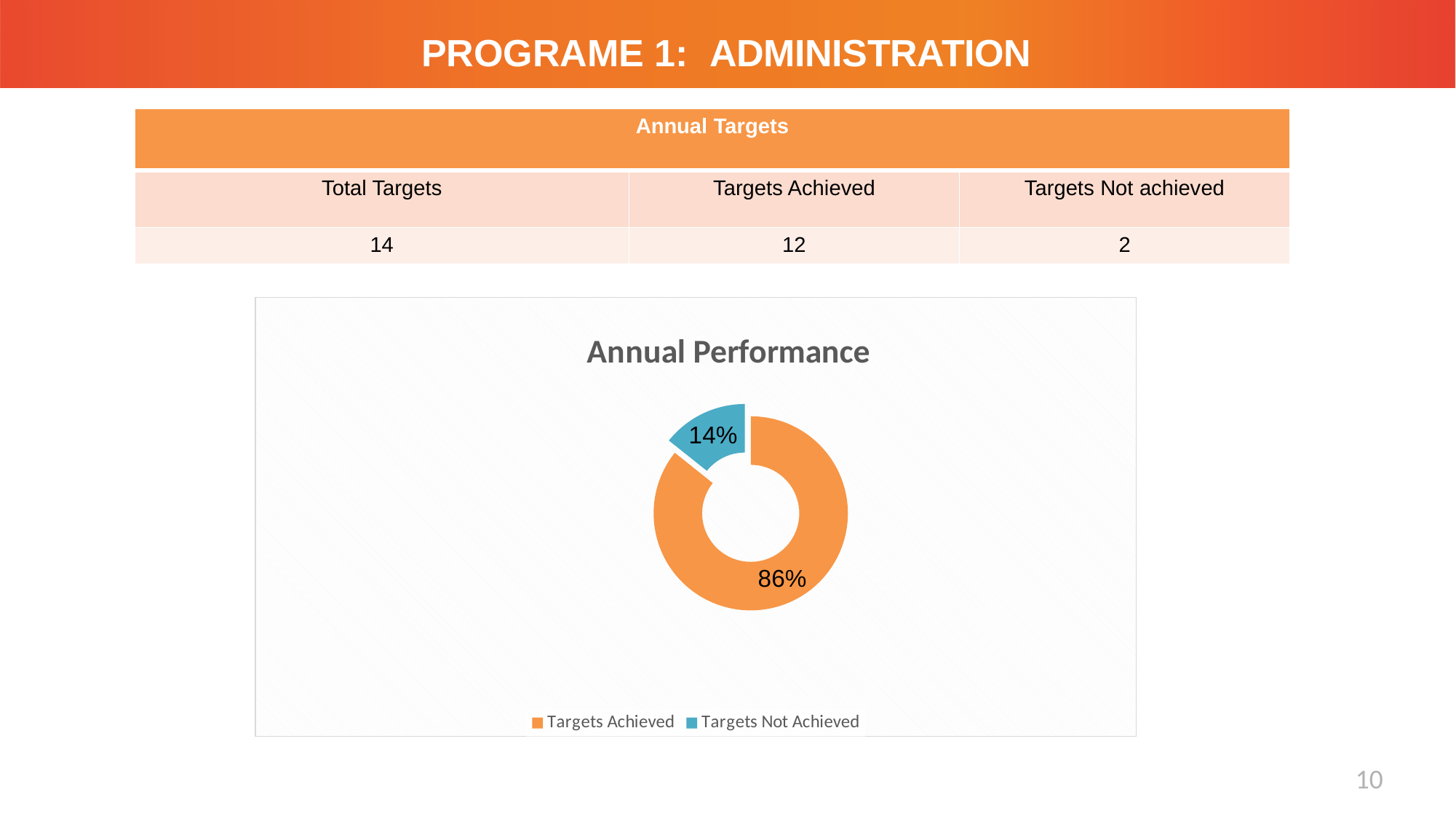
Which is larger in the chart: Targets Achieved or Targets Not Achieved? Targets Achieved What colour represents Targets Not Achieved in the chart? Blue What percentage does the chart show for Targets Not Achieved? 14% Which category has the largest share in the chart? Targets Achieved What is the title of the chart? Annual Performance What is the difference in percentage points between Targets Achieved and Targets Not Achieved? 72 How many categories does the chart's legend list? 2 What kind of chart is shown under the title 'Annual Performance'? Doughnut chart Which category has the smallest share in the chart? Targets Not Achieved Is the share for Targets Achieved greater or less than 50%? greater What percentage does the chart show for Targets Achieved? 86%